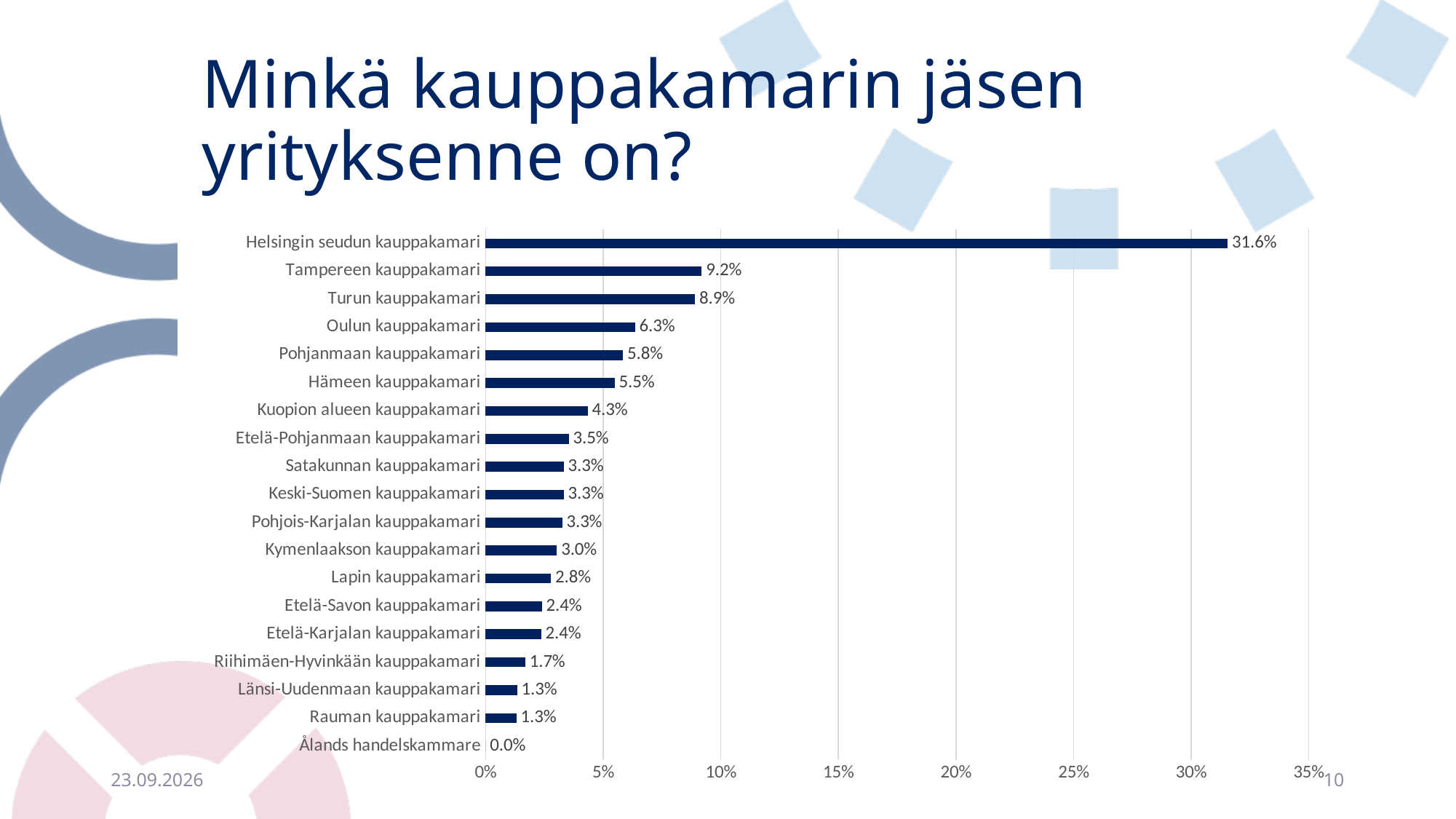
Which category has the lowest value? Ålands handelskammare What is the value for Helsingin seudun kauppakamari? 31.6% What is the difference between the values for Tampereen kauppakamari and Turun kauppakamari? 0.3% What is the value for Oulun kauppakamari? 6.3% Which category has the highest value? Helsingin seudun kauppakamari Which is larger, the value for Pohjanmaan kauppakamari or Hämeen kauppakamari? Pohjanmaan kauppakamari What is the value for Lapin kauppakamari? 2.8% Is the value for Helsingin seudun kauppakamari greater or less than 30%? greater What kind of chart is shown on the slide? bar chart What is the title of the slide? Minkä kauppakamarin jäsen yrityksenne on? What is the difference between the values for Kuopion alueen kauppakamari and Kymenlaakson kauppakamari? 1.3% How many categories are shown in the chart? 19